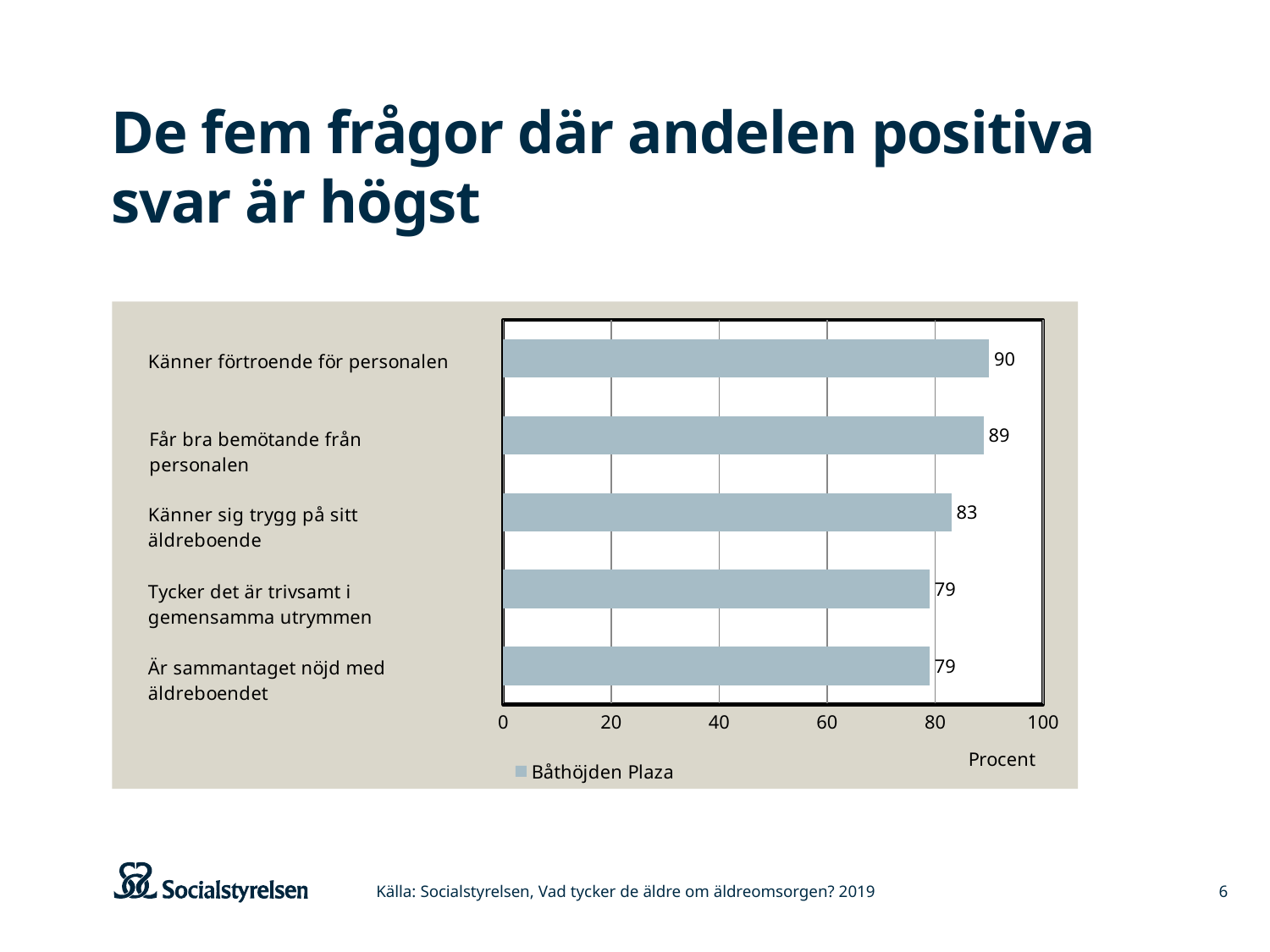
What series name does the legend show? Båthöjden Plaza What is the value for "Känner förtroende för personalen"? 90 What is the value for "Får bra bemötande från personalen"? 89 Is the value for "Tycker det är trivsamt i gemensamma utrymmen" greater or less than 60? greater What kind of chart is shown on the slide? bar chart What is the value for "Är sammantaget nöjd med äldreboendet"? 79 How many categories are shown in the chart? 5 What is the difference between the values for "Får bra bemötande från personalen" and "Tycker det är trivsamt i gemensamma utrymmen"? 10 Which is larger, the value for "Känner sig trygg på sitt äldreboende" or the value for "Är sammantaget nöjd med äldreboendet"? Känner sig trygg på sitt äldreboende Which category has the highest value? Känner förtroende för personalen What is the value for "Känner sig trygg på sitt äldreboende"? 83 What is the difference between the values for "Känner förtroende för personalen" and "Känner sig trygg på sitt äldreboende"? 7